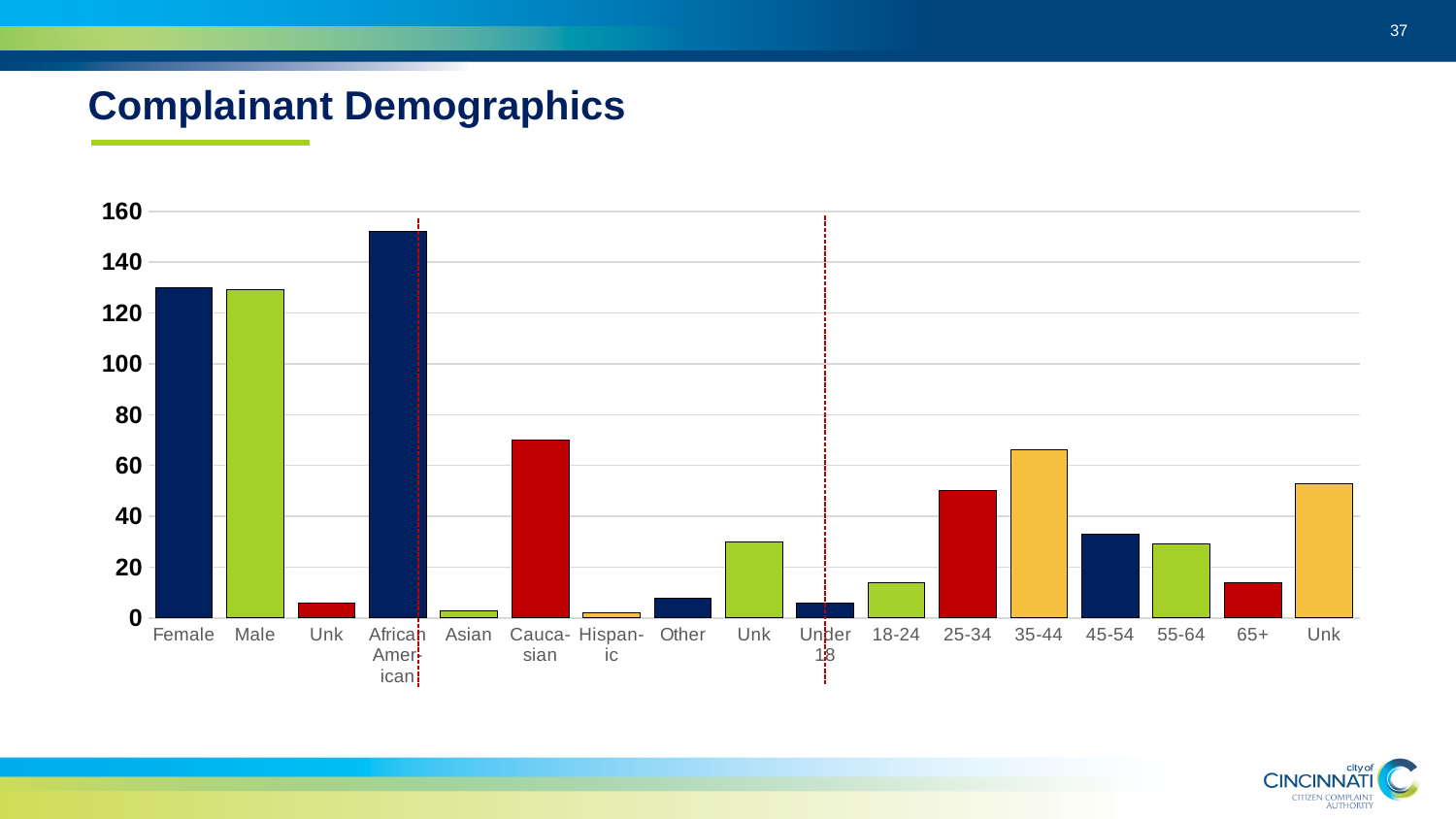
Is the value for the Unk bar in the age group (rightmost bar) greater or less than 40? greater Which category has the highest bar? African American Is the value for Caucasian greater or less than 80? less What type of chart is shown on the slide? bar chart Is the value for Asian greater or less than 20? less What is the title of the chart? Complainant Demographics Which is larger, the value for 25-34 or the value for 45-54? 25-34 How many categories are plotted along the x axis? 17 Which is larger, the value for 35-44 or the value for 65+? 35-44